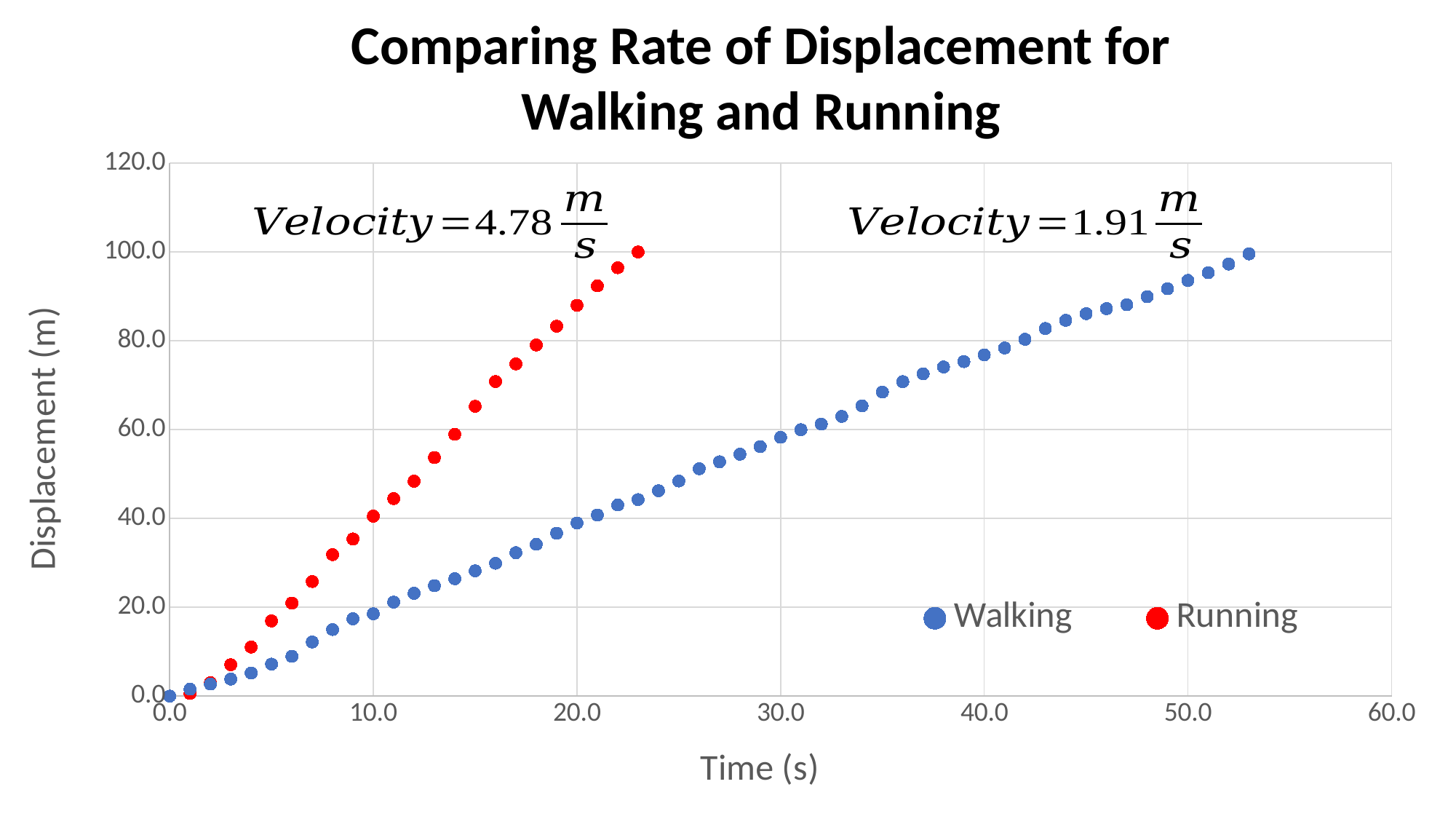
What velocity is stated for the Running series? 4.78 m/s How many series does the legend list? 2 Do the Running displacement values rise or fall as time increases? Rise Is the Running displacement at 20.0 s greater or less than 80.0 m? greater Do the Walking displacement values rise or fall as time increases? Rise What velocity is stated for the Walking series? 1.91 m/s Is the Walking displacement at 50.0 s greater or less than 80.0 m? greater What kind of chart is shown on the slide? Scatter chart Is the Walking displacement at 20.0 s greater or less than 60.0 m? less At 20.0 s, which series has the larger displacement, Walking or Running? Running Which series reaches a displacement of 100.0 m in less time, Walking or Running? Running